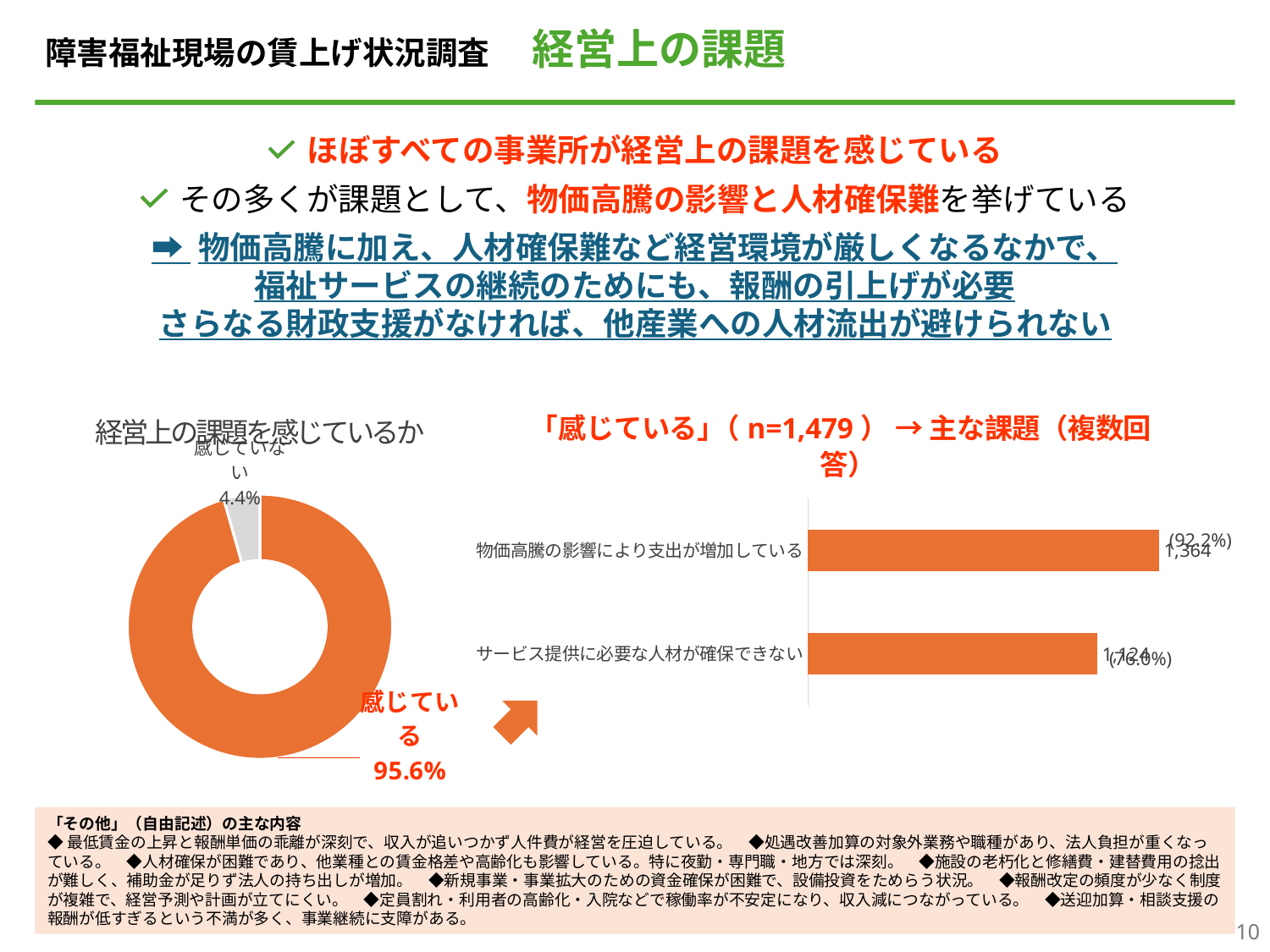
How many categories are plotted in the bar chart on the right (主な課題)? 2 What is the n value shown in the title of the bar chart on the right? n=1,479 In the donut chart titled 経営上の課題を感じているか, which category has the larger share? 感じている In the bar chart on the right (主な課題), which item has the higher count? 物価高騰の影響により支出が増加している In the bar chart on the right (主な課題), what is the difference in respondent counts between 物価高騰の影響により支出が増加している and サービス提供に必要な人材が確保できない? 240 In the donut chart titled 経営上の課題を感じているか, what percentage of respondents answered 感じていない? 4.4% In the donut chart titled 経営上の課題を感じているか, what percentage of respondents answered 感じている? 95.6% What type of chart is the chart titled 経営上の課題を感じているか? Donut (pie) chart In the bar chart on the right (主な課題), how many respondents selected 物価高騰の影響により支出が増加している? 1,364 In the donut chart titled 経営上の課題を感じているか, what is the difference in percentage points between 感じている and 感じていない? 91.2 In the bar chart on the right (主な課題), what percentage is shown for サービス提供に必要な人材が確保できない? 76.0% In the bar chart on the right (主な課題), what percentage is shown for 物価高騰の影響により支出が増加している? 92.2%